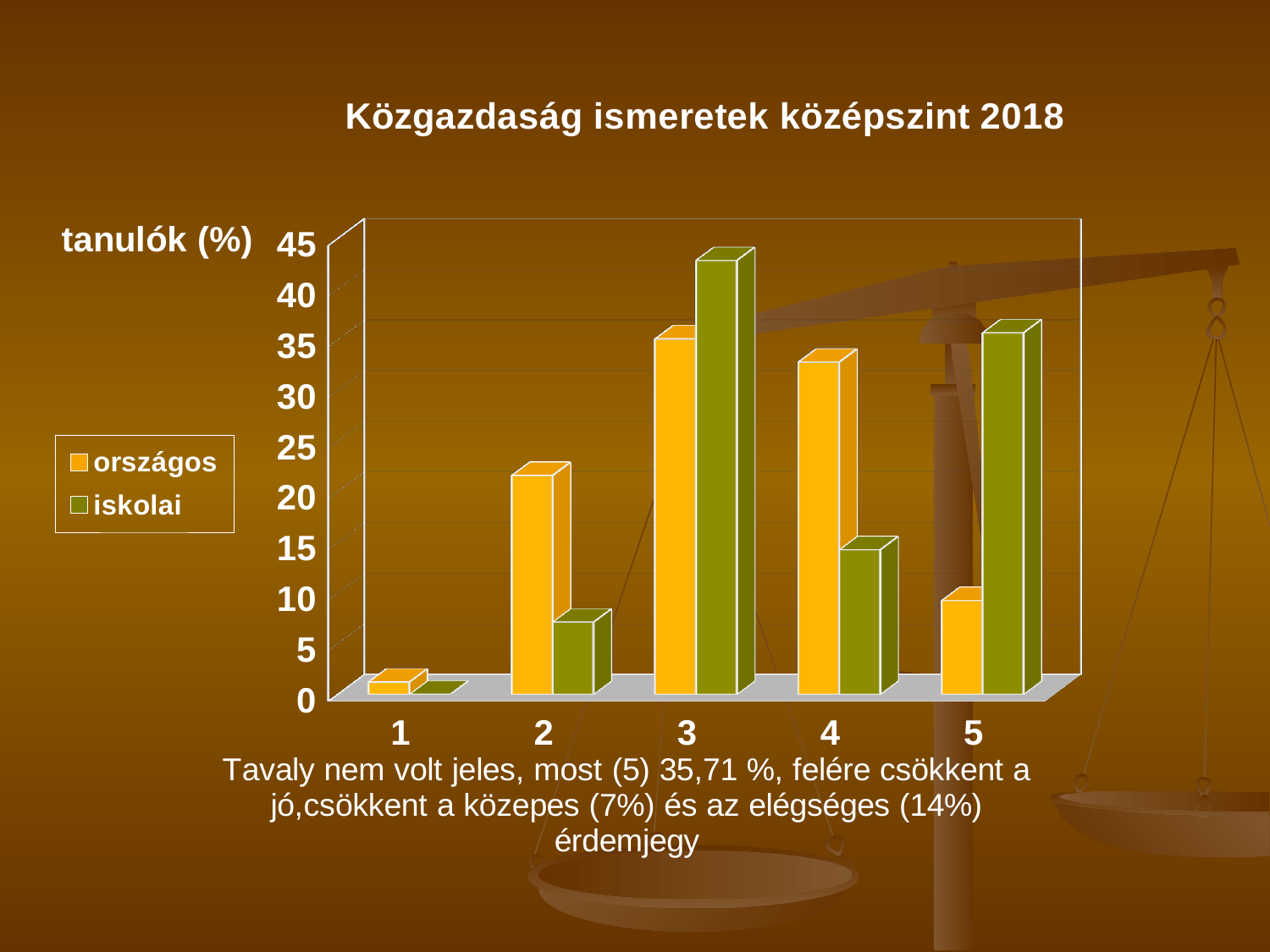
For which category is the iskolai value lowest? 1 How many series does the legend list? 2 How many categories are shown on the x axis? 5 What is the title of the chart? Közgazdaság ismeretek középszint 2018 Is the iskolai value for category 3 greater or less than 40? greater For category 5, which series has the larger value, országos or iskolai? iskolai Is the iskolai value for category 2 greater or less than 10? less What label is shown on the vertical axis? tanulók (%) What kind of chart is shown on the slide? bar chart For category 2, which series has the larger value, országos or iskolai? országos For which category is the iskolai value highest? 3 For which category is the országos value lowest? 1